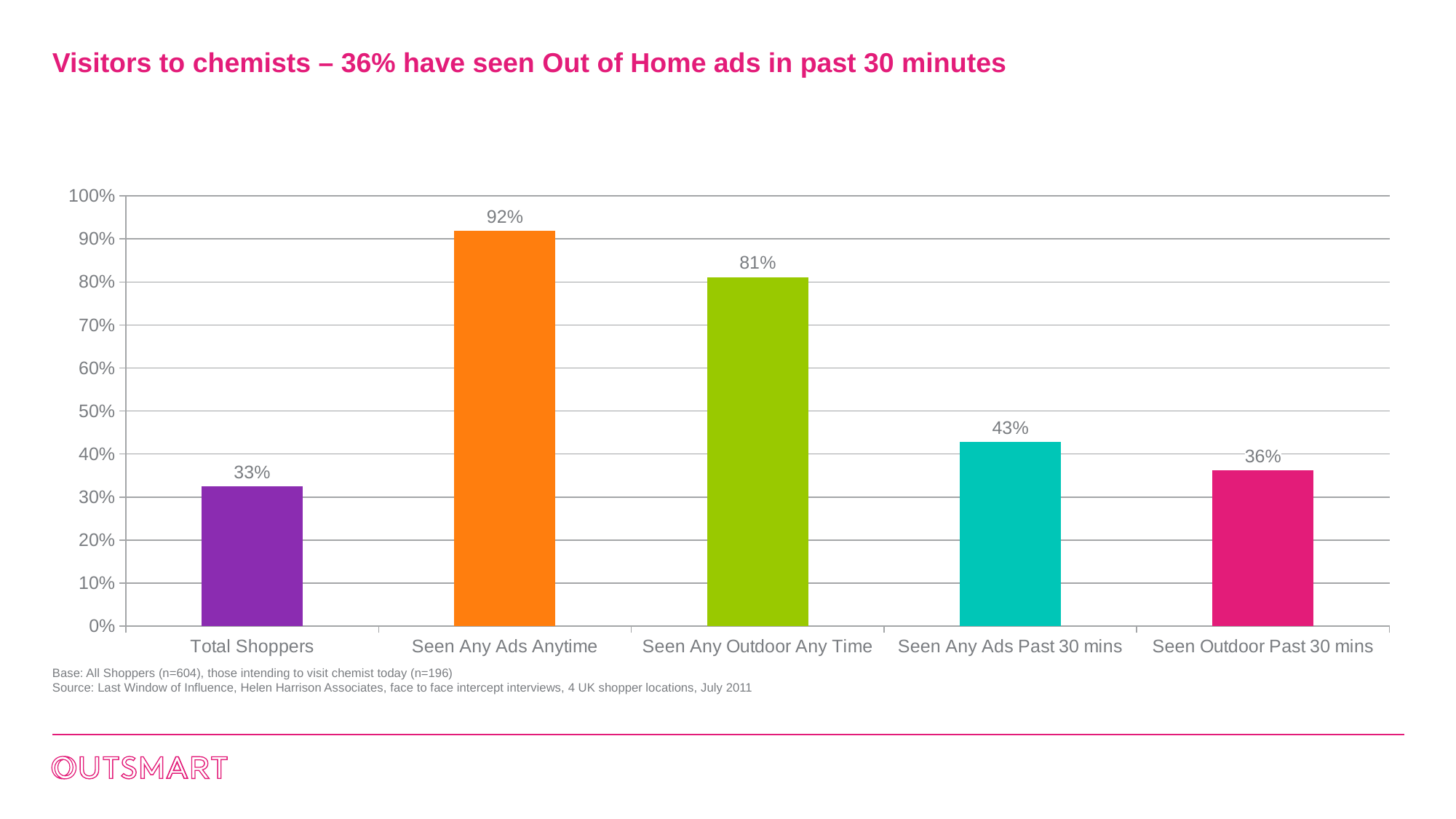
Which category has the highest value? Seen Any Ads Anytime What kind of chart is shown on the slide? Bar chart What is the value for Seen Any Ads Anytime? 92% What is the value for Seen Outdoor Past 30 mins? 36% What is the value for Total Shoppers? 33% Which is larger, Seen Any Ads Past 30 mins or Seen Outdoor Past 30 mins? Seen Any Ads Past 30 mins What colour is the bar for Seen Any Ads Anytime? Orange What is the difference between Seen Any Ads Anytime and Seen Any Outdoor Any Time? 11% What is the value for Seen Any Ads Past 30 mins? 43% Is the value for Seen Any Outdoor Any Time greater or less than 70%? greater Which category has the lowest value? Total Shoppers How many categories are shown on the chart? 5